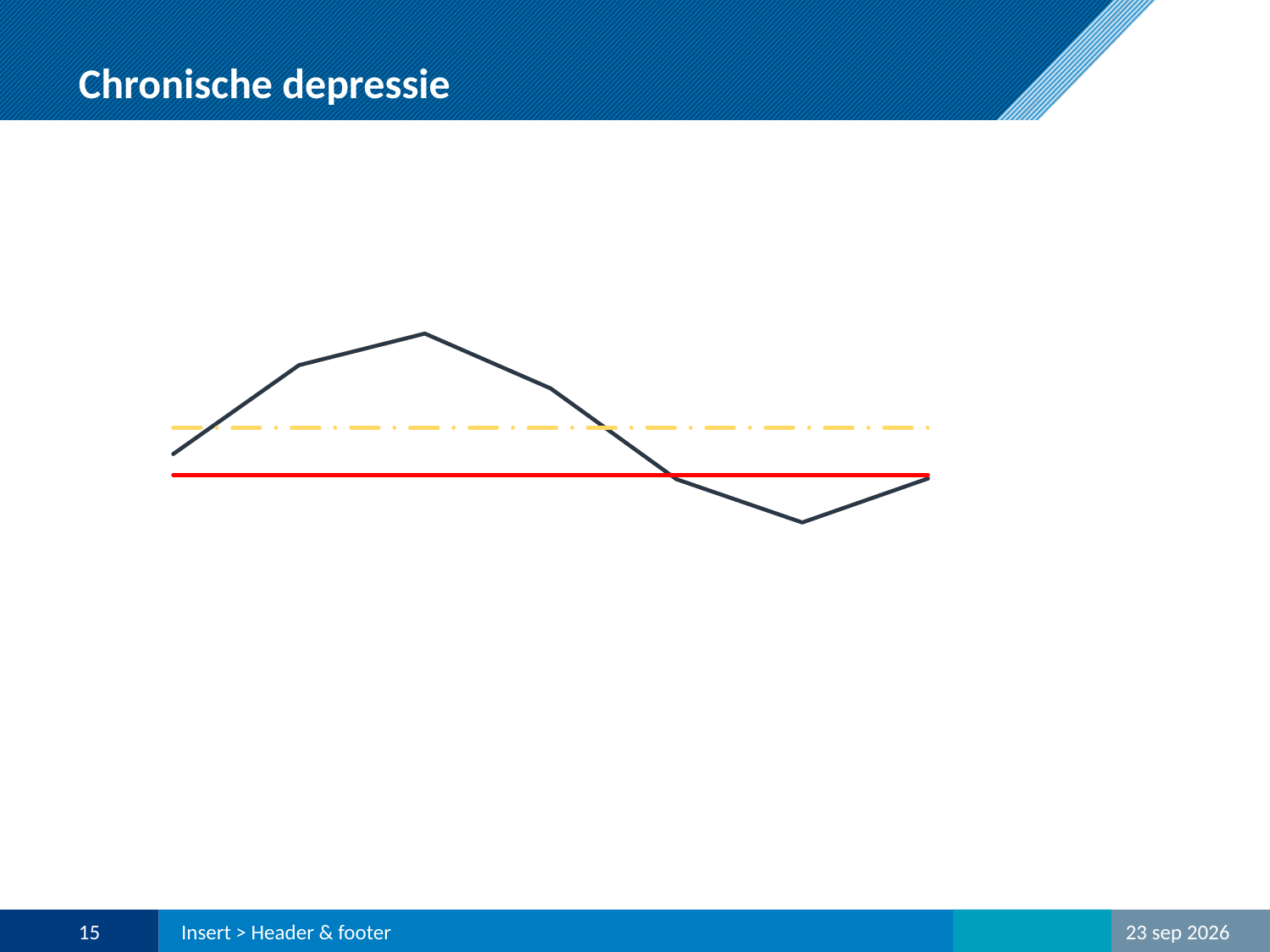
What colour is the dashed horizontal line in the chart? yellow How many data points does the dark line have? 7 Does the dark line rise or fall from its first point to its third point? rise Does the dark line rise or fall from its third point to its sixth point? fall What is the title of the slide containing the chart? Chronische depressie What kind of chart is shown on the slide? line chart